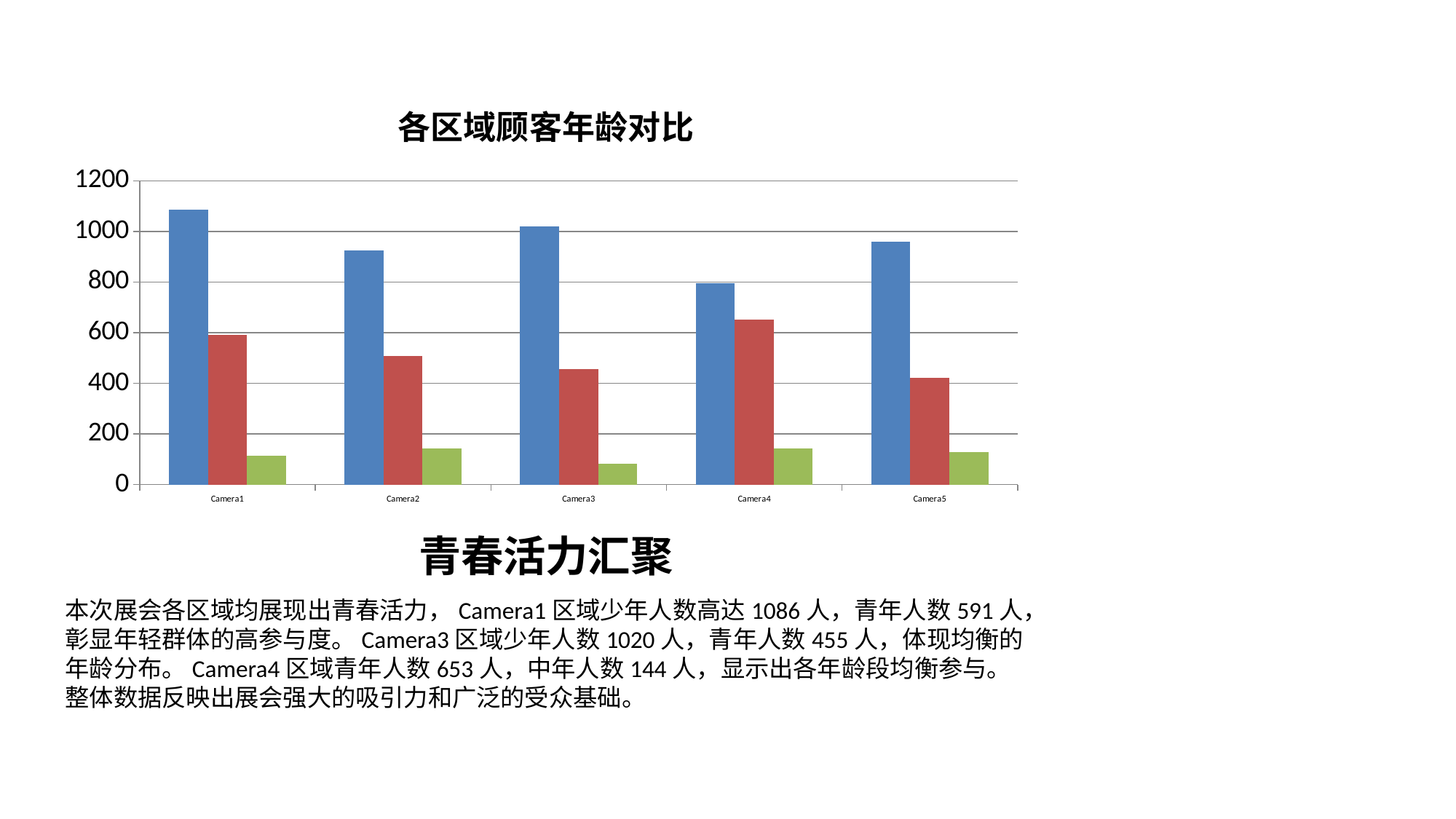
Which category has the shortest green bar? Camera3 What is the title of the chart? 各区域顾客年龄对比 Is the blue bar for Camera2 greater or less than 800? greater How many categories are shown on the x axis of the chart? 5 Which is taller, the red bar for Camera1 or the red bar for Camera2? Camera1 Is the red bar for Camera4 greater or less than 600? greater How many differently coloured bars are shown for each camera category? 3 Which category has the tallest red bar? Camera4 Is the green bar for Camera3 greater or less than 200? less What type of chart is shown on the slide? Bar chart Which category has the shortest blue bar? Camera4 Which category has the tallest blue bar? Camera1